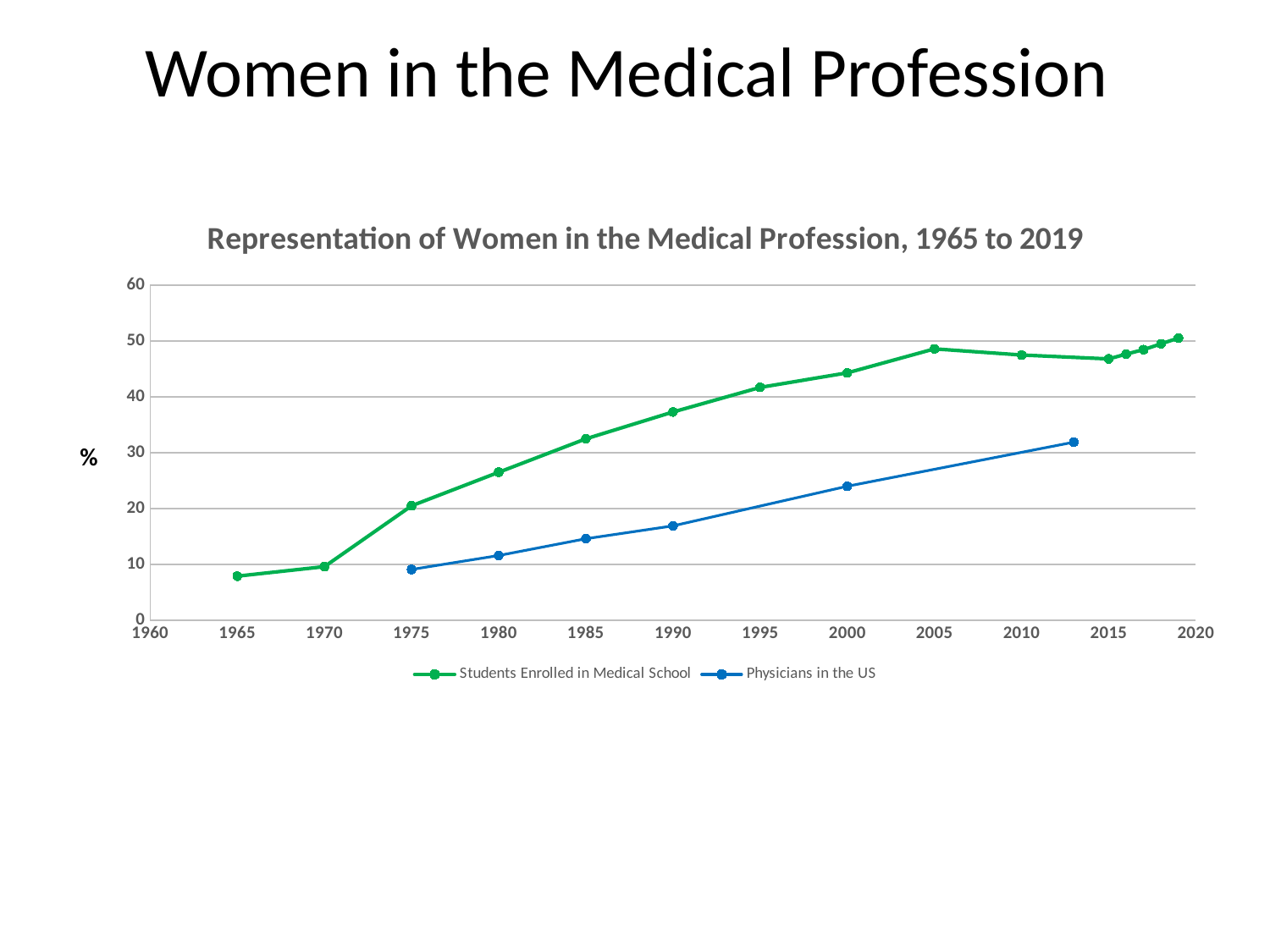
How many series does the legend list? 2 What colour is the line for Physicians in the US? blue In 1990, which series has the higher value, Students Enrolled in Medical School or Physicians in the US? Students Enrolled in Medical School What kind of chart is shown on the slide? line chart Do the values for Physicians in the US rise or fall over time along the x axis? rise Is the value for Physicians in the US in 2000 greater or less than 20? greater In which year is the value for Students Enrolled in Medical School lowest? 1965 What is the title of the chart? Representation of Women in the Medical Profession, 1965 to 2019 Is the value for Students Enrolled in Medical School in 2005 greater or less than 40? greater Is the value for Students Enrolled in Medical School in 1990 greater or less than 30? greater How many data points are plotted for Physicians in the US? 6